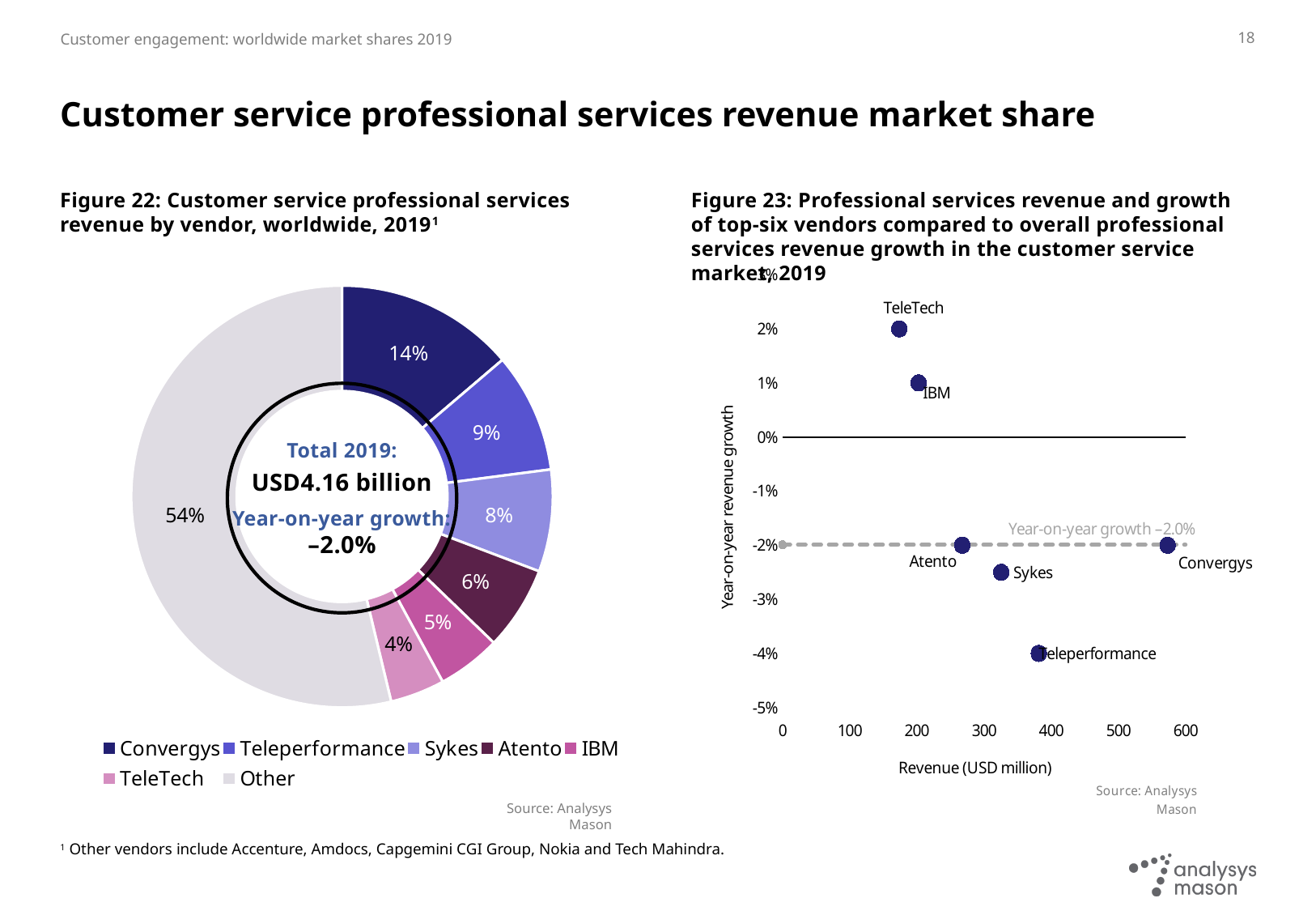
In Figure 22, how many segments does the chart have? 7 In Figure 22, which has the larger share, Atento or Sykes? Sykes In Figure 22, which vendor has the smallest share? TeleTech What type of chart is Figure 22? Pie (donut) chart In Figure 22, what share is shown for Sykes? 8% In Figure 22, what share of customer service professional services revenue does Convergys hold? 14% In Figure 22, what is the difference in percentage points between the shares of Teleperformance and IBM? 4 percentage points In Figure 23, is the year-on-year revenue growth for Teleperformance greater or less than -3%? less In Figure 23, is the revenue for Convergys greater or less than 500 USD million? greater In Figure 22, what total 2019 revenue is shown in the centre of the chart? USD4.16 billion In Figure 22, what share is shown for TeleTech? 4% In Figure 22, which named vendor (excluding Other) has the largest share? Convergys